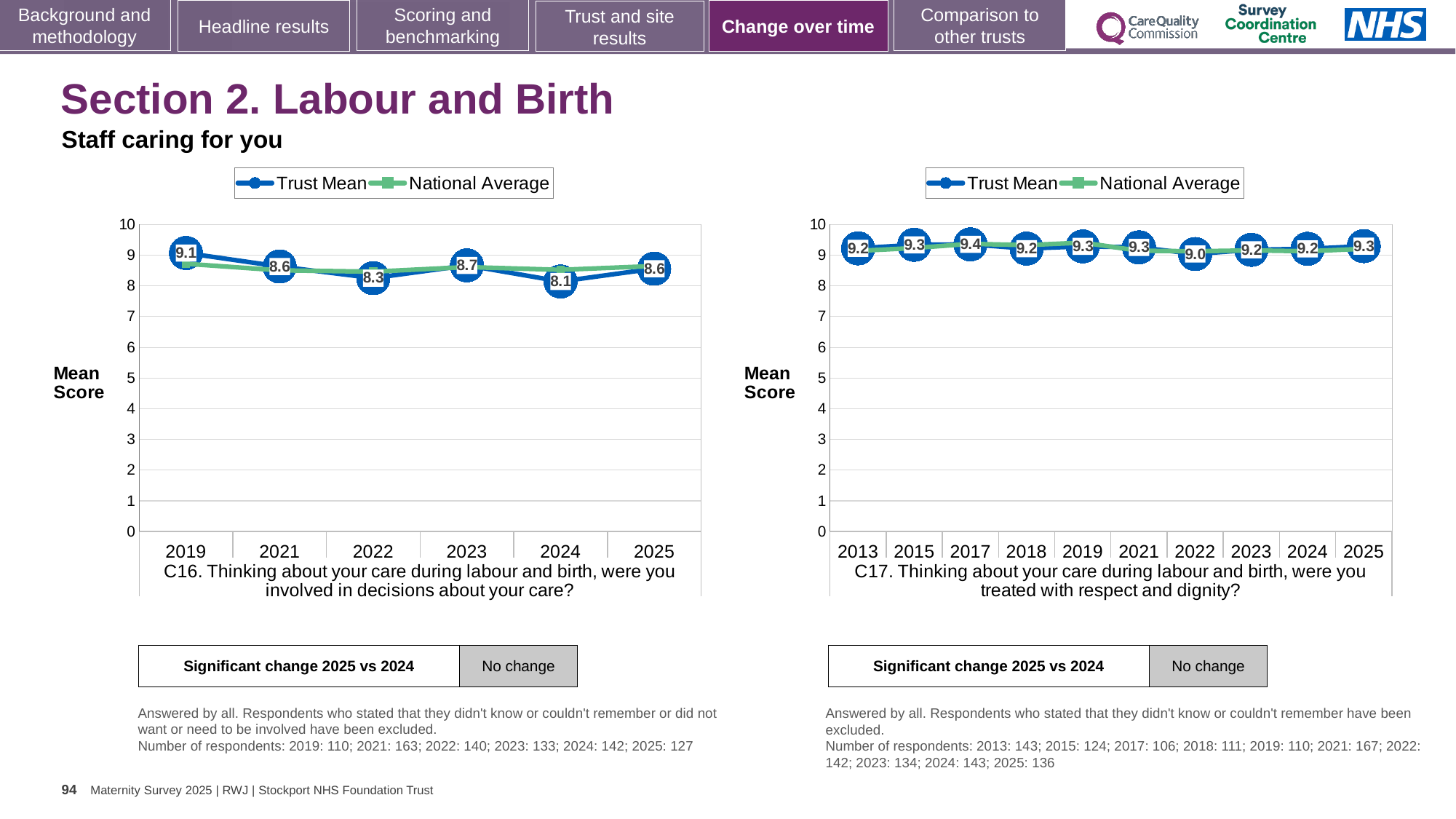
In the C17 chart (right), which year has the lowest Trust Mean score? 2022 In the C16 chart (left), what is the Trust Mean score for 2024? 8.1 In the C16 chart (left), what is the difference between the Trust Mean scores for 2019 and 2024? 1.0 What kind of chart is the C16 chart (left)? Line chart In the C16 chart (left), which year has the highest Trust Mean score? 2019 In the C17 chart (right), what is the Trust Mean score for 2022? 9.0 In the C17 chart (right), how many series does the legend list? 2 In the C17 chart (right), is the Trust Mean score for 2025 greater or less than 8? greater In the C16 chart (left), how many years are plotted on the x axis? 6 In the C16 chart (left), which year has the lowest Trust Mean score? 2024 In the C16 chart (left), what is the Trust Mean score for 2019? 9.1 In the C17 chart (right), which year has the highest Trust Mean score? 2017